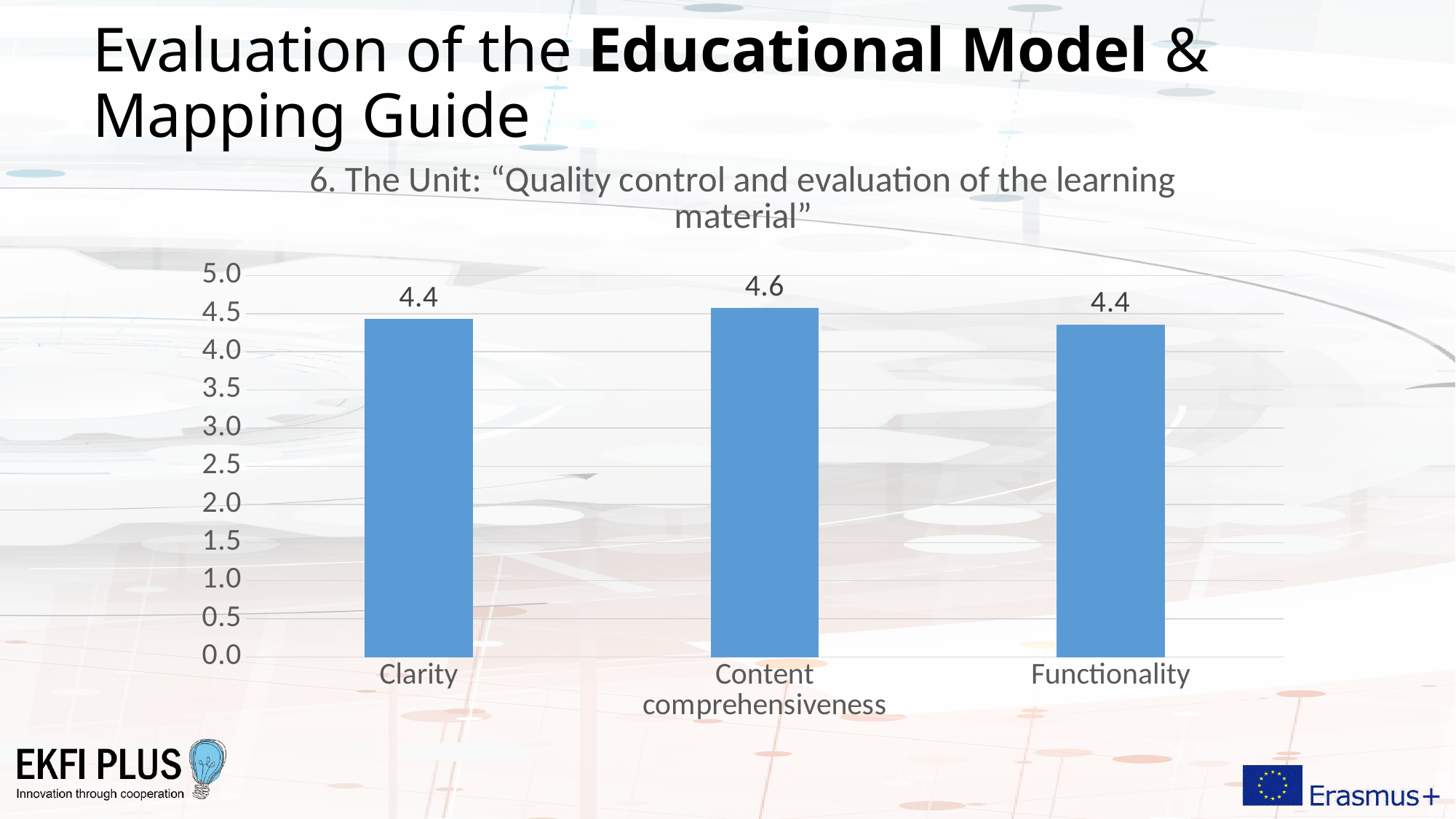
What is the title of the chart? 6. The Unit: "Quality control and evaluation of the learning material" Which is larger, the value for Content comprehensiveness or the value for Functionality? Content comprehensiveness What is the value for Content comprehensiveness? 4.6 Which category has the highest value? Content comprehensiveness Is the value for Clarity greater or less than 4.0? greater What kind of chart is shown on the slide? Bar chart How many categories are shown in the chart? 3 What is the difference between the values for Content comprehensiveness and Clarity? 0.2 Is the value for Content comprehensiveness greater or less than 5.0? less What is the value for Functionality? 4.4 What is the maximum value shown on the vertical axis? 5.0 What is the value for Clarity? 4.4